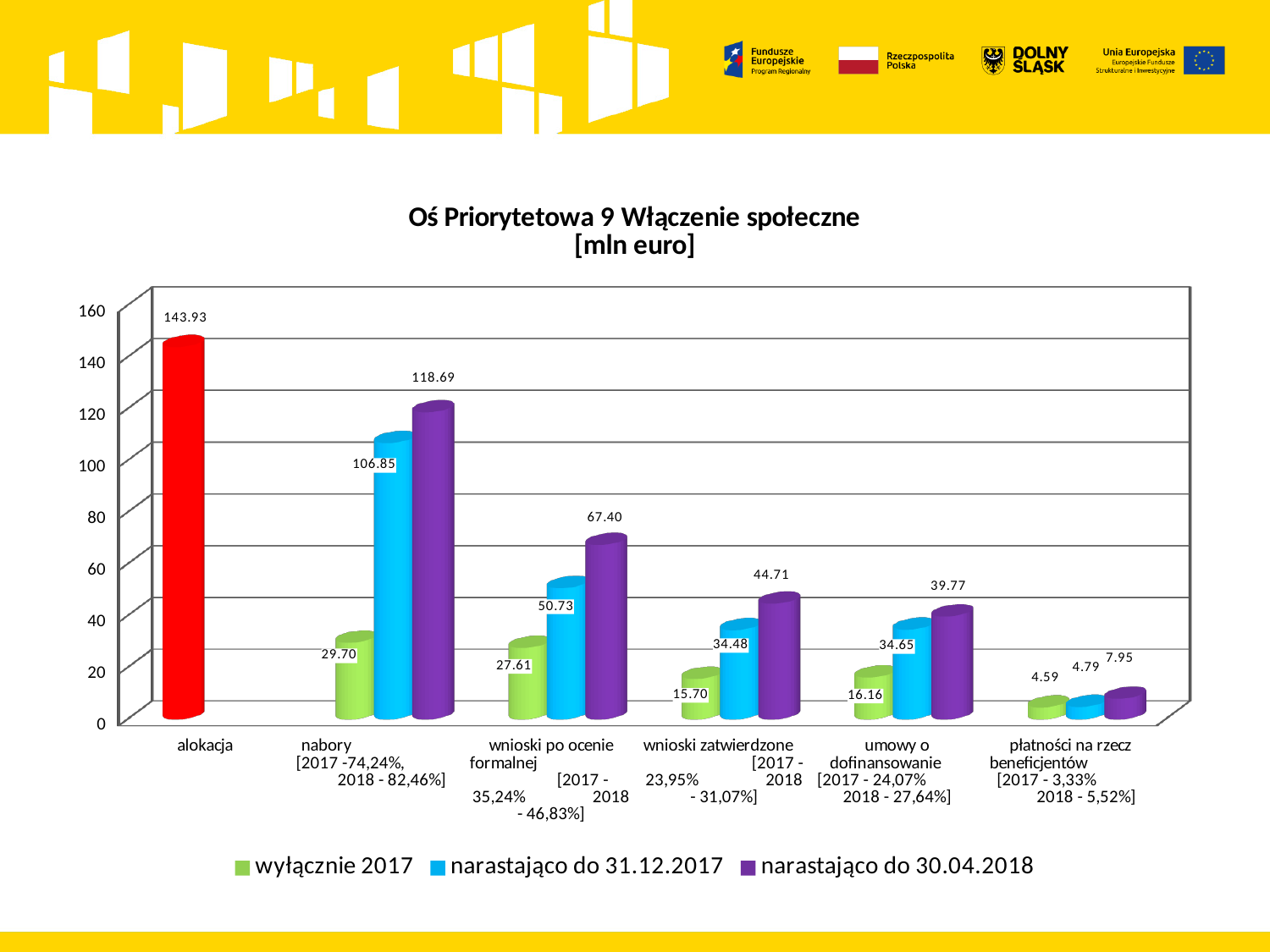
How many categories are shown on the x axis? 6 Which is larger: the 'narastająco do 30.04.2018' value for 'wnioski zatwierdzone' or for 'umowy o dofinansowanie'? wnioski zatwierdzone How many series does the legend list? 3 What is the value of 'wyłącznie 2017' for 'wnioski zatwierdzone'? 15.70 What is the value of 'narastająco do 30.04.2018' for 'nabory'? 118.69 Which category has the lowest value for the 'narastająco do 30.04.2018' series? płatności na rzecz beneficjentów What is the value shown for 'alokacja'? 143.93 Which category has the highest value for the 'wyłącznie 2017' series? nabory What unit is given in the chart title? mln euro What kind of chart is shown on the slide? bar chart What is the value of 'narastająco do 31.12.2017' for 'umowy o dofinansowanie'? 34.65 What is the difference between the 'narastająco do 30.04.2018' and 'narastająco do 31.12.2017' values for 'wnioski po ocenie formalnej'? 16.67